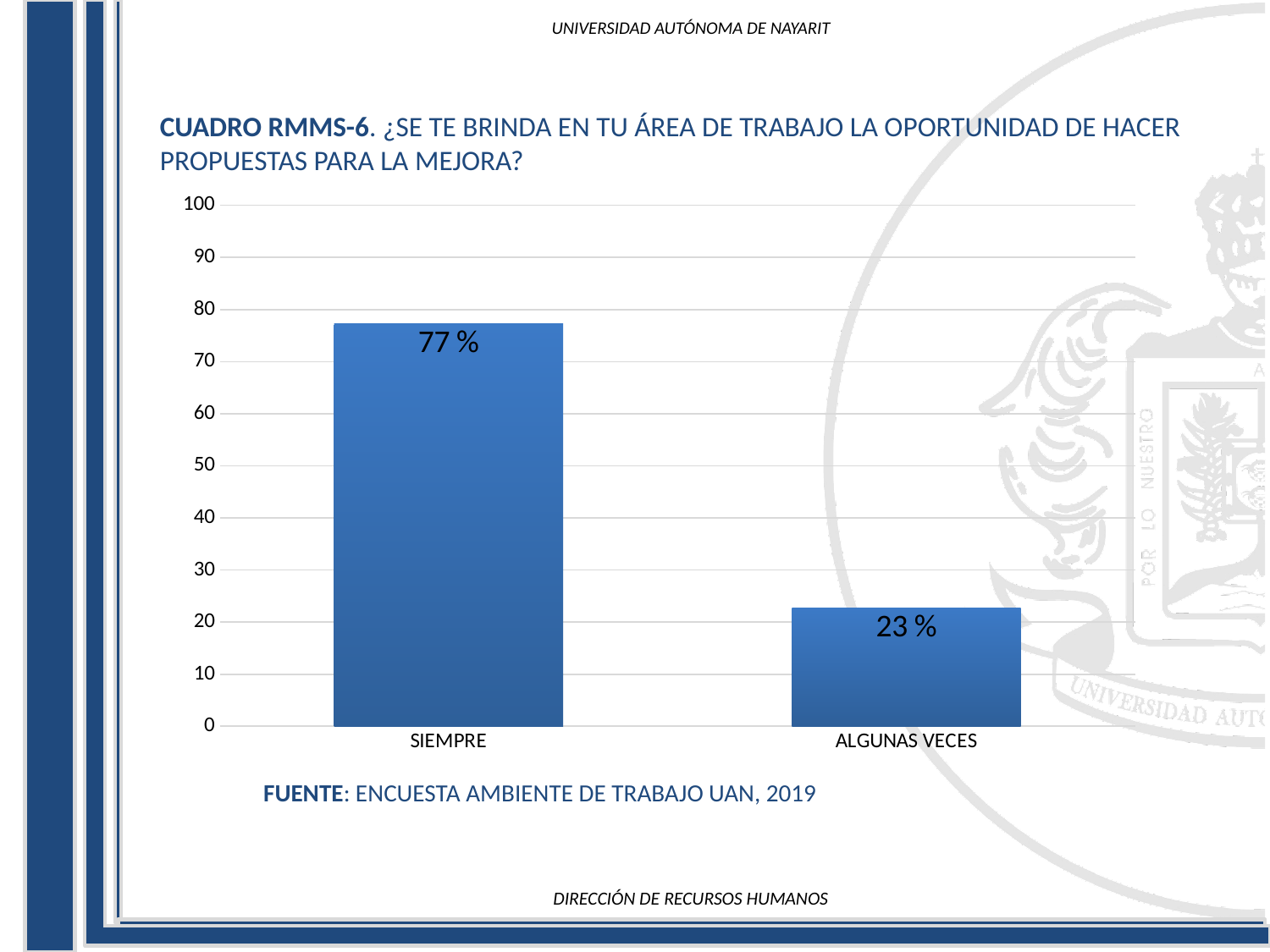
What is the value for SIEMPRE? 77 % Which category has the highest value? SIEMPRE What is the total of the two values shown in the chart? 100 % Is the value for SIEMPRE greater or less than 70? greater What is the value for ALGUNAS VECES? 23 % Which is larger, the value for SIEMPRE or the value for ALGUNAS VECES? SIEMPRE Which category has the lowest value? ALGUNAS VECES Is the value for ALGUNAS VECES greater or less than 30? less How many categories are shown on the x axis? 2 What kind of chart is shown on the slide? bar chart What source is cited below the chart? ENCUESTA AMBIENTE DE TRABAJO UAN, 2019 What is the difference between the values for SIEMPRE and ALGUNAS VECES? 54 %